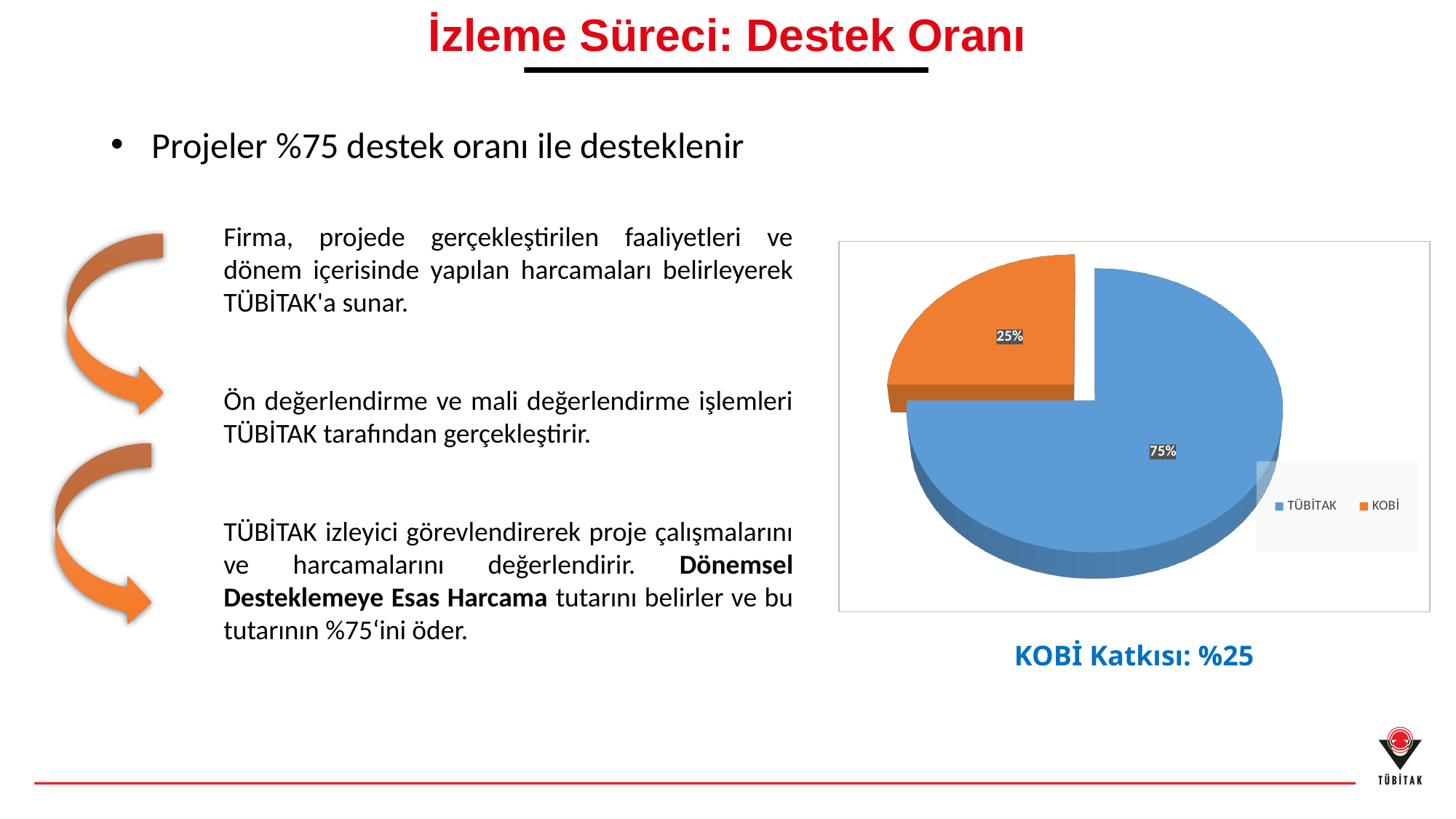
Which slice of the pie is the largest? TÜBİTAK How many slices does the pie chart have? 2 How many entries does the legend list? 2 What share of the pie does TÜBİTAK account for? 75% What kind of chart is shown on the slide? Pie chart Which is larger, the TÜBİTAK slice or the KOBİ slice? TÜBİTAK What share of the pie does KOBİ account for? 25% What colour is the KOBİ slice in the pie chart? Orange What is the difference in percentage points between the TÜBİTAK and KOBİ slices? 50 percentage points Which slice of the pie is the smallest? KOBİ What colour is the TÜBİTAK slice in the pie chart? Blue